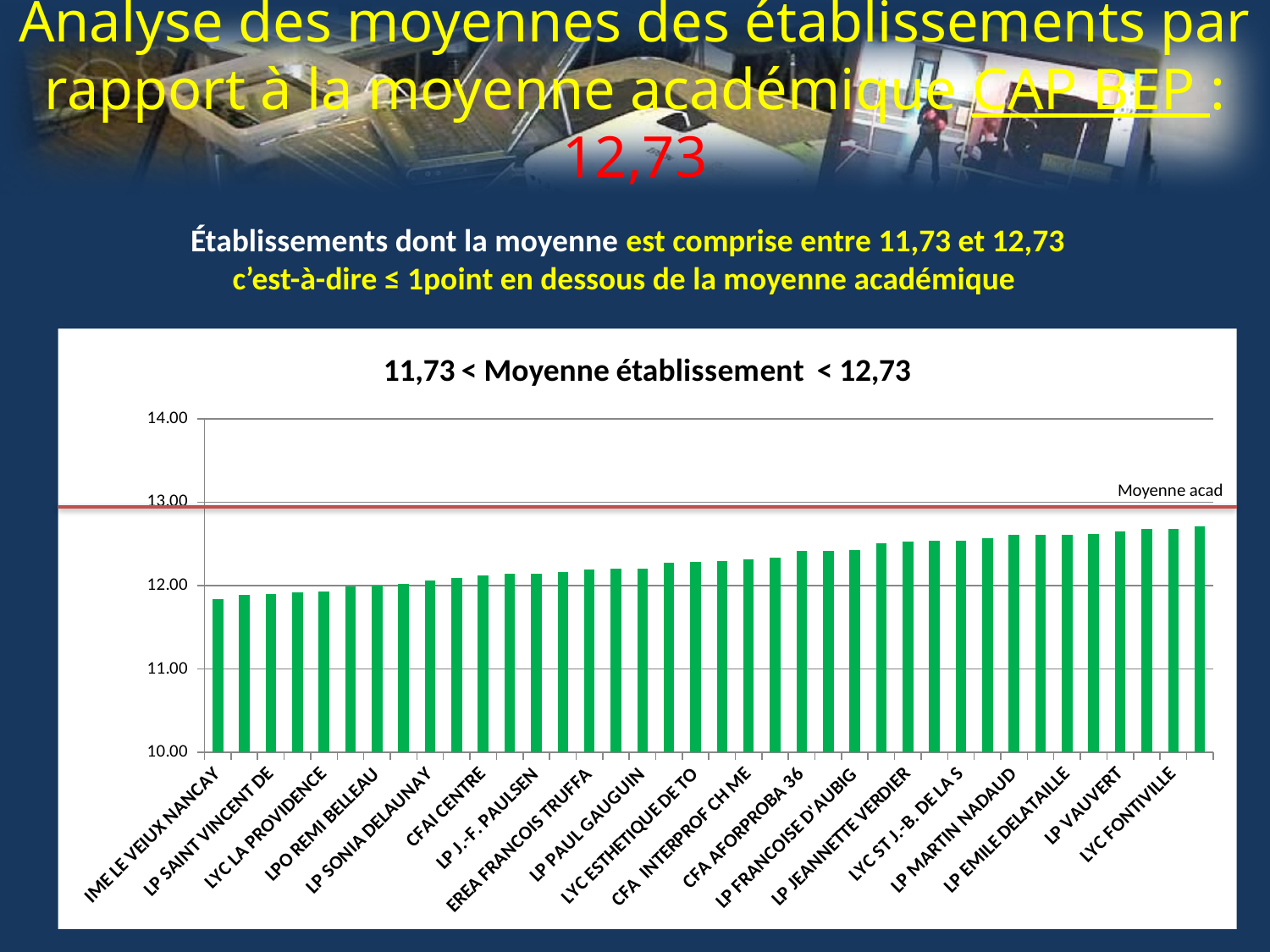
Which is larger, the value for LYC FONTIVILLE or the value for IME LE VIEUX NANCAY? LYC FONTIVILLE Is the value for IME LE VIEUX NANCAY greater or less than 12.00? less What is the title of the chart? 11,73 < Moyenne établissement < 12,73 Is the value for LP SAINT VINCENT DE greater or less than 13.00? less Is the value for CFA AFORPROBA 36 greater or less than 12.00? greater What kind of chart is shown on the slide? bar chart Which establishment has the lowest value on the chart? IME LE VEIUX NANCAY What does the horizontal red line on the chart represent, according to its label? Moyenne acad Do the bar values rise or fall from left to right along the x axis? rise Which is larger, the value for LP VAUVERT or the value for LPO REMI BELLEAU? LP VAUVERT